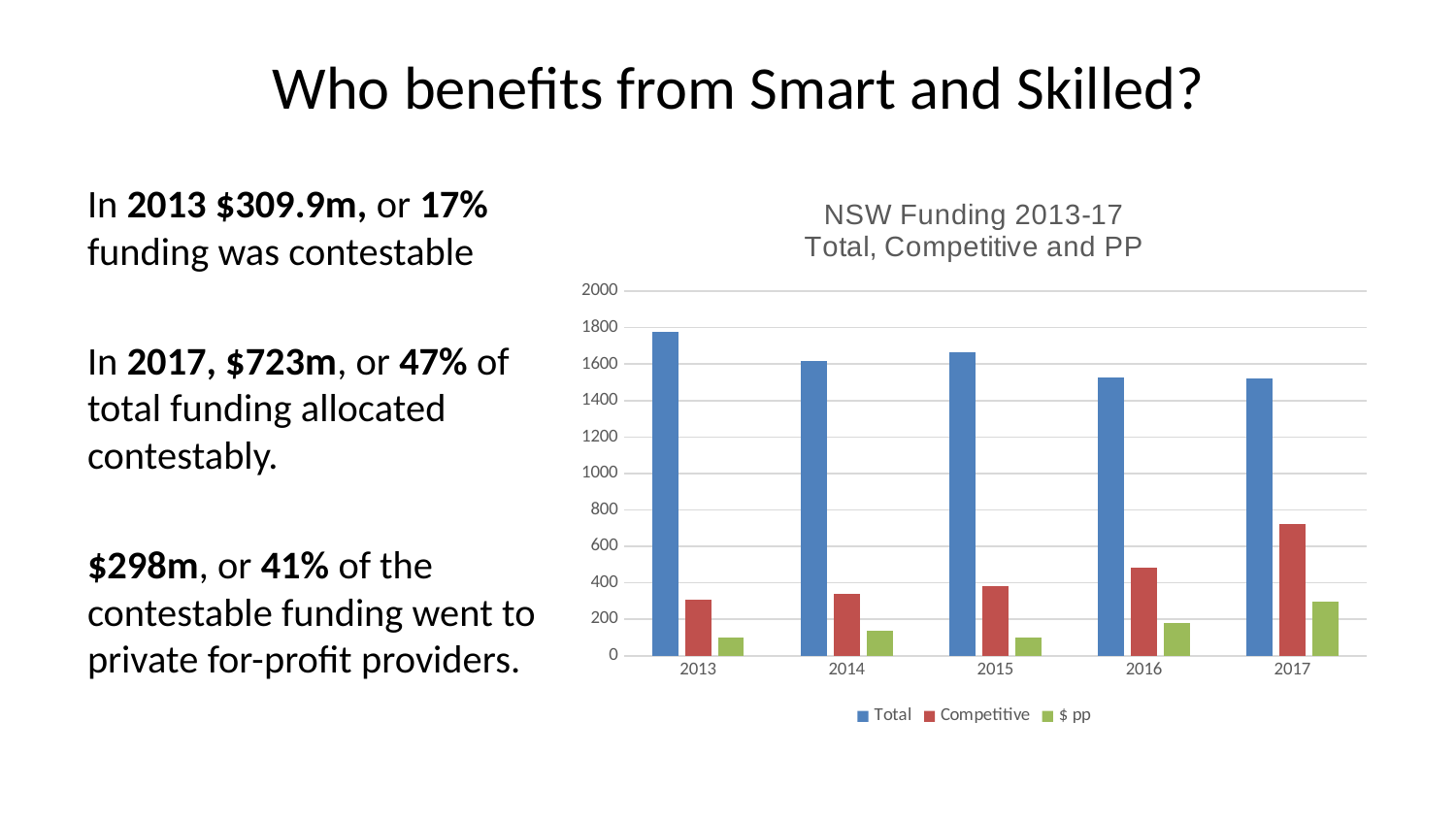
Is the $ pp value for 2017 greater or less than 400? less Is the Competitive value for 2017 greater or less than 600? greater What is the title of the chart? NSW Funding 2013-17 Total, Competitive and PP Is the Total value for 2013 greater or less than 1600? greater In which year is the $ pp series highest? 2017 What kind of chart is shown on the slide? bar chart How many years are shown on the x axis of the NSW Funding chart? 5 Does the Competitive series rise or fall from 2013 to 2017? rise In which year is the Competitive series highest? 2017 Which is larger, the Competitive value for 2016 or for 2017? 2017 In which year is the Total series highest? 2013 How many series does the legend of the NSW Funding chart list? 3